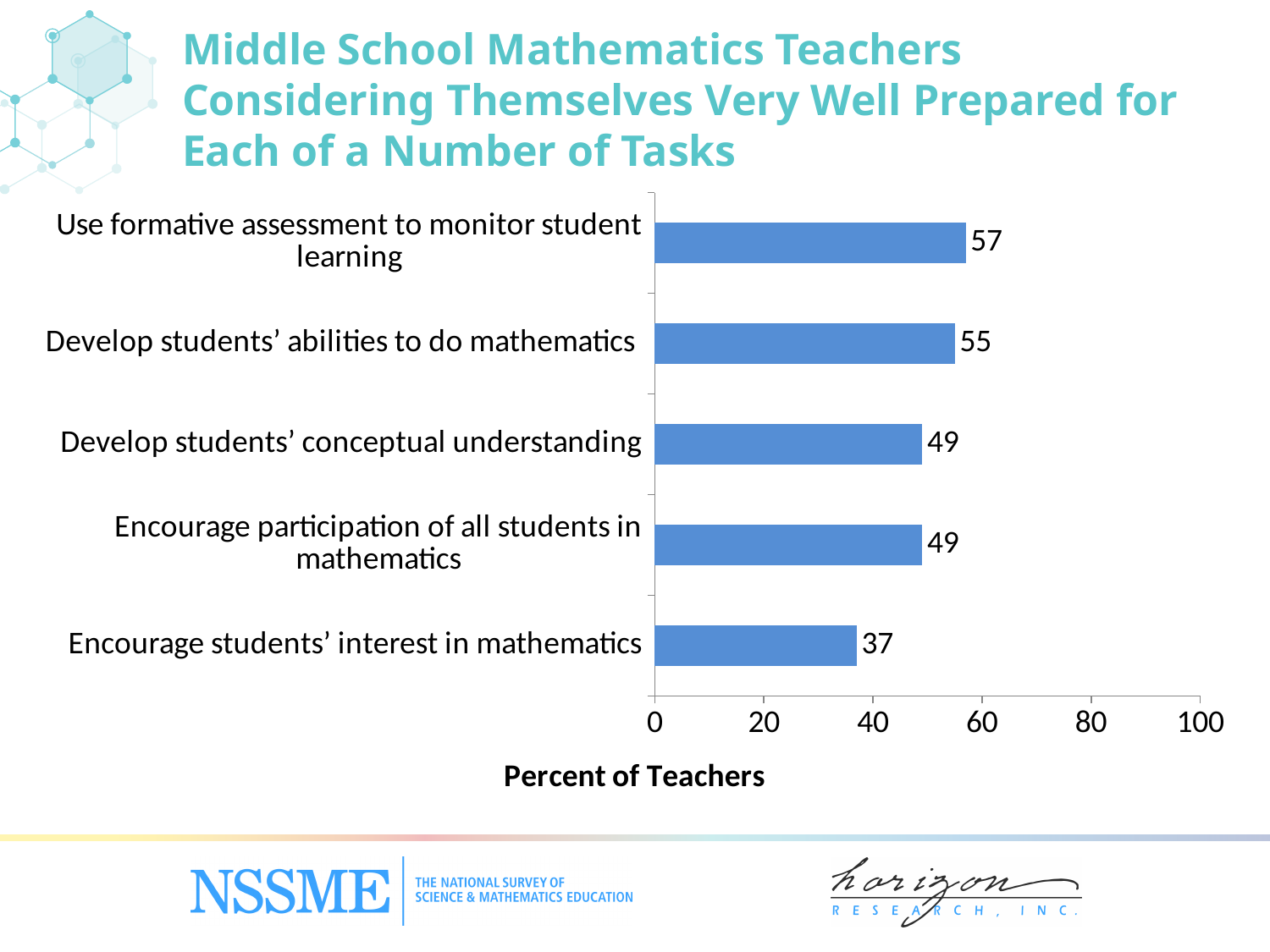
What is the label of the horizontal axis? Percent of Teachers What is the difference between the values for "Use formative assessment to monitor student learning" and "Encourage students' interest in mathematics"? 20 Which task has the lowest percent of teachers considering themselves very well prepared? Encourage students' interest in mathematics What is the value for "Develop students' abilities to do mathematics"? 55 Is the value for "Encourage participation of all students in mathematics" greater or less than 40? greater Which task has the highest percent of teachers considering themselves very well prepared? Use formative assessment to monitor student learning What kind of chart is shown on the slide? Bar chart What percent of teachers consider themselves very well prepared to use formative assessment to monitor student learning? 57 Which is larger: the value for "Develop students' conceptual understanding" or the value for "Encourage students' interest in mathematics"? Develop students' conceptual understanding What is the difference between the values for "Develop students' abilities to do mathematics" and "Develop students' conceptual understanding"? 6 What is the value for "Encourage students' interest in mathematics"? 37 How many tasks are shown in the chart? 5